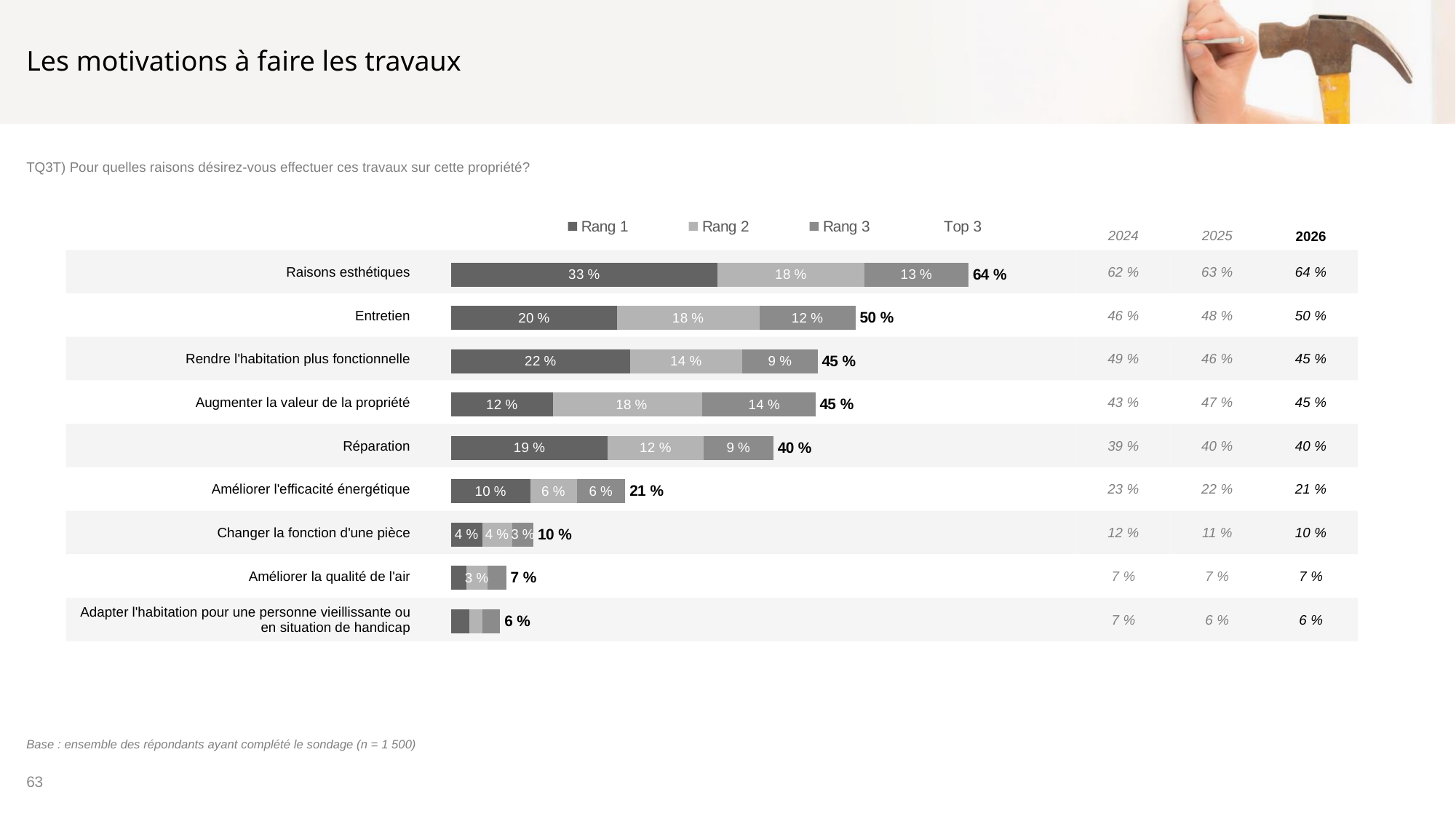
How many categories are shown in the chart? 9 Which has a larger Rang 1 value, Rendre l'habitation plus fonctionnelle or Augmenter la valeur de la propriété? Rendre l'habitation plus fonctionnelle Which category has the lowest Top 3 value? Adapter l'habitation pour une personne vieillissante ou en situation de handicap What is the Top 3 value for Améliorer l'efficacité énergétique? 21 % What is the difference between the Top 3 values for Raisons esthétiques and Entretien? 14 % What kind of chart is shown on the slide? Stacked bar chart How many entries does the chart legend list? 4 What is the Rang 1 value for Raisons esthétiques? 33 % What is the Top 3 value for Entretien? 50 % What is the Rang 3 value for Réparation? 9 % Which category has the highest Top 3 value? Raisons esthétiques What is the Rang 2 value for Augmenter la valeur de la propriété? 18 %